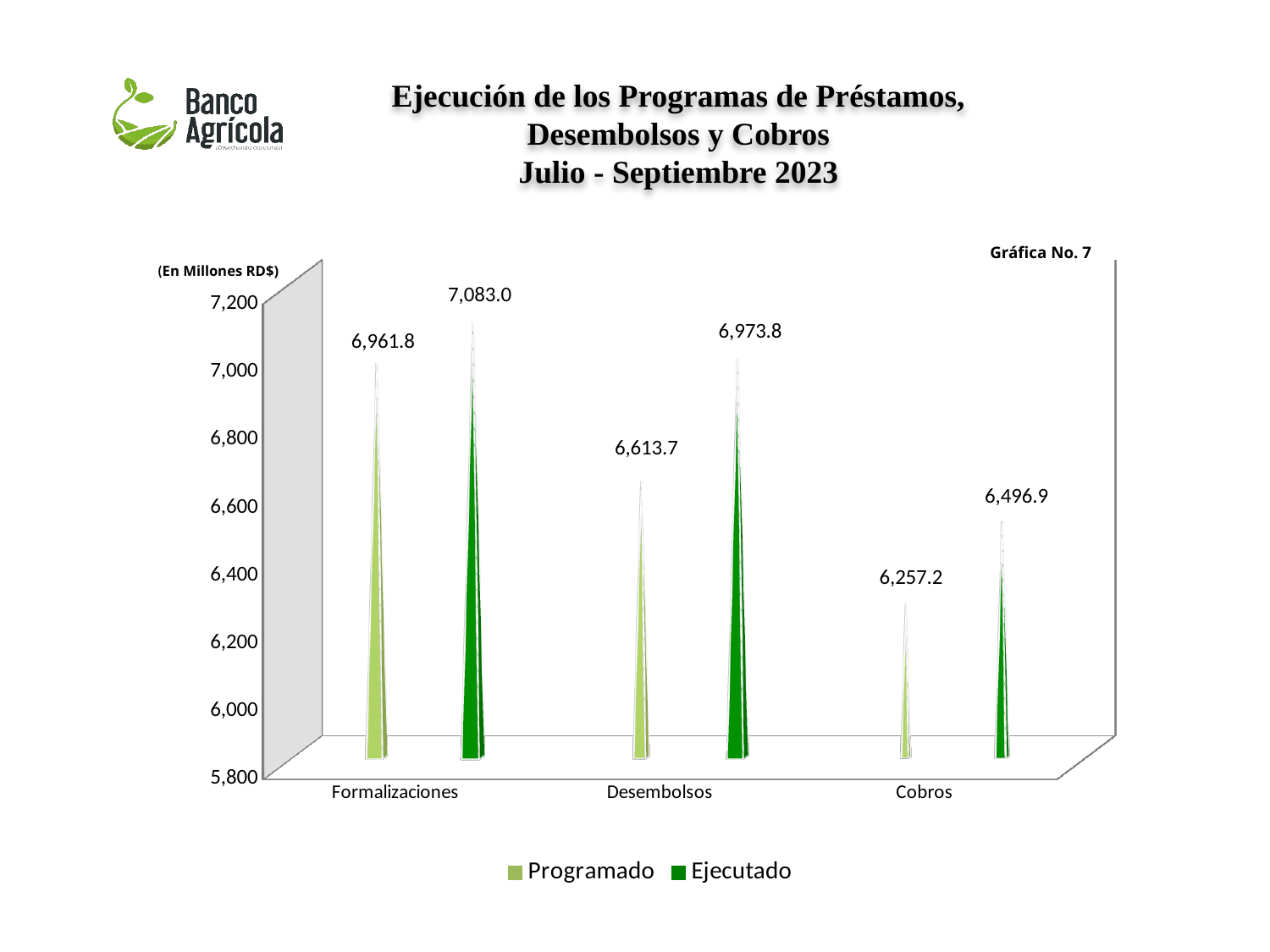
How many categories are shown on the x axis? 3 What is the Programado value for Formalizaciones? 6,961.8 What is the difference between the Ejecutado and Programado values for Formalizaciones? 121.2 Which is larger for Cobros, the Programado value or the Ejecutado value? Ejecutado What unit is stated for the values in the chart? En Millones RD$ What is the Ejecutado value for Desembolsos? 6,973.8 What is the Ejecutado value for Cobros? 6,496.9 What is the difference between the Ejecutado and Programado values for Desembolsos? 360.1 Which category has the highest Ejecutado value? Formalizaciones Which category has the lowest Programado value? Cobros What is the Programado value for Cobros? 6,257.2 How many series does the legend list? 2